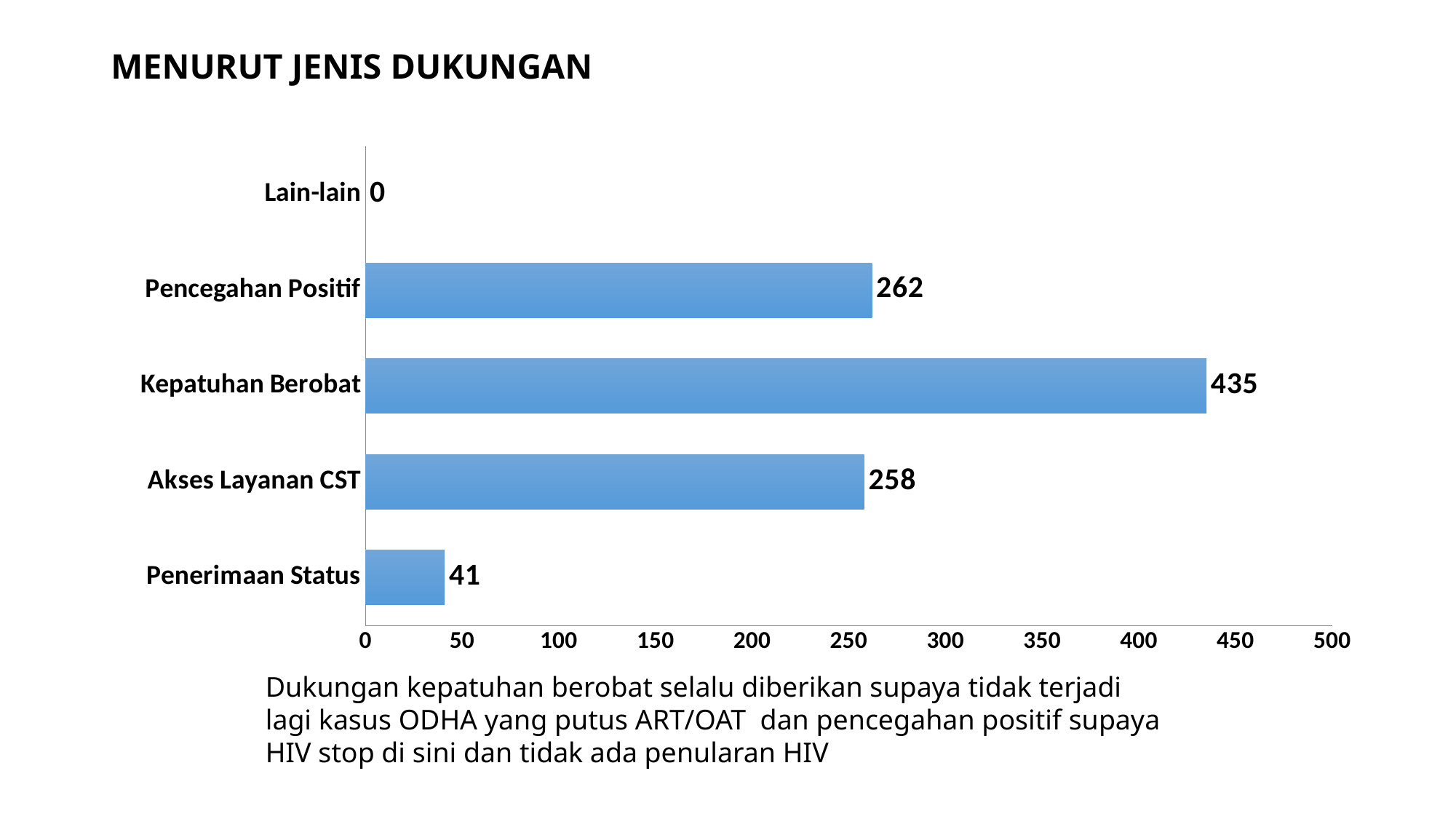
What is the title of the slide? MENURUT JENIS DUKUNGAN Which category has the lowest value? Lain-lain What is the value for Akses Layanan CST? 258 How many categories are shown in the chart? 5 Which category has the highest value? Kepatuhan Berobat What is the value for Kepatuhan Berobat? 435 What is the difference between Kepatuhan Berobat and Pencegahan Positif? 173 What kind of chart is shown on the slide? Bar chart What is the value for Penerimaan Status? 41 What is the difference between Pencegahan Positif and Akses Layanan CST? 4 Which is larger, Akses Layanan CST or Penerimaan Status? Akses Layanan CST What is the value for Lain-lain? 0